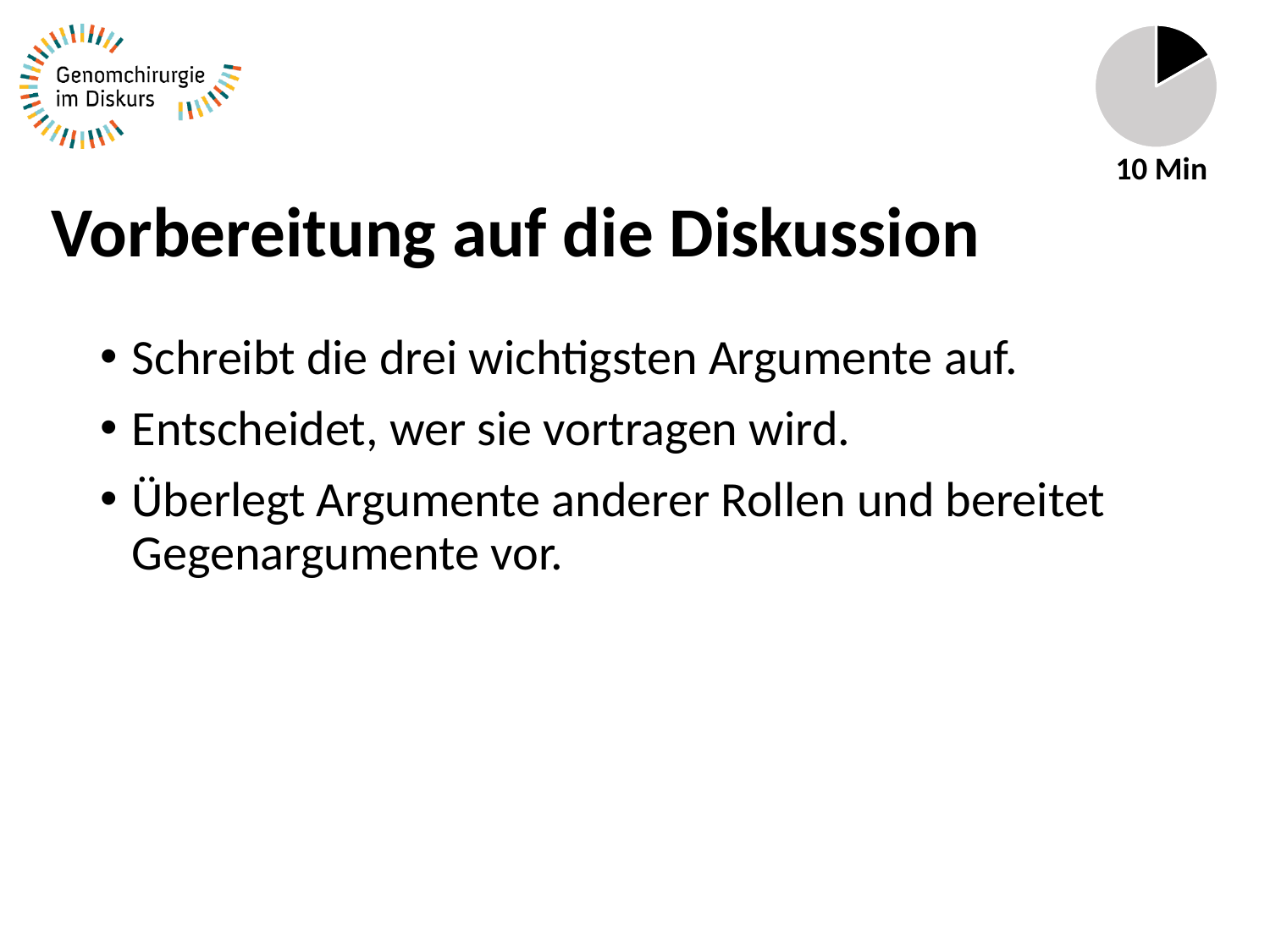
How many segments does the pie chart in the top-right corner have? 2 In the pie chart in the top-right corner, which segment is larger, the black one or the grey one? grey What colour is the smaller segment of the pie chart in the top-right corner? black In the pie chart in the top-right corner, which segment is smaller, the black one or the grey one? black What label is printed directly below the pie chart in the top-right corner? 10 Min What kind of chart is shown in the top-right corner of the slide? pie chart